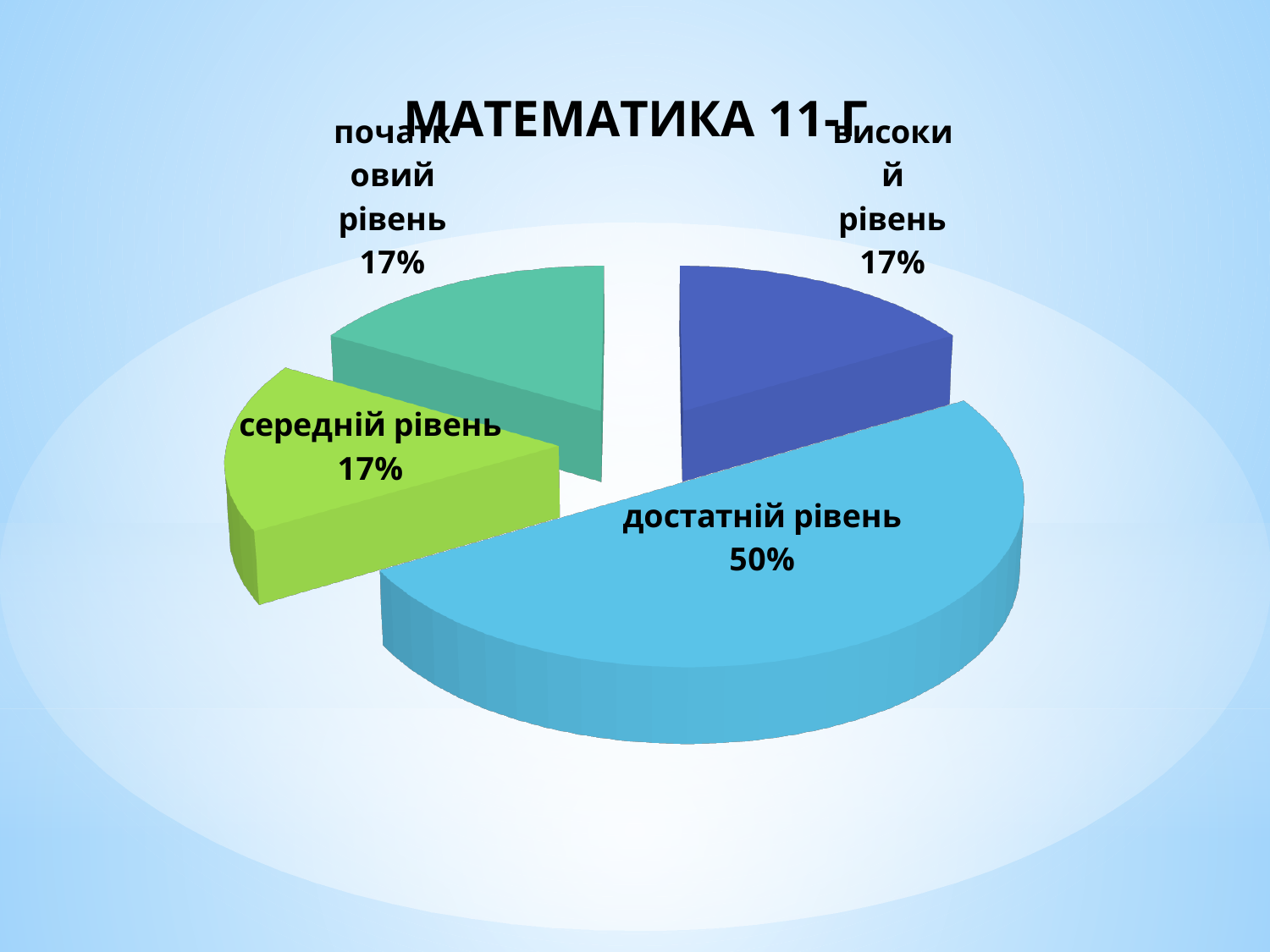
What kind of chart is shown on the slide? pie chart What share of the pie does достатній рівень have? 50% What is the difference between the value for достатній рівень and the value for високий рівень? 33% Which category has the largest slice of the pie? достатній рівень What is the title of the chart? МАТЕМАТИКА 11-Г What is the value shown for високий рівень? 17% What colour is the slice for середній рівень? green What is the value shown for початковий рівень? 17% Which is larger, the slice for достатній рівень or the slice for середній рівень? достатній рівень How many slices does the pie chart have? 4 What is the value shown for середній рівень? 17%